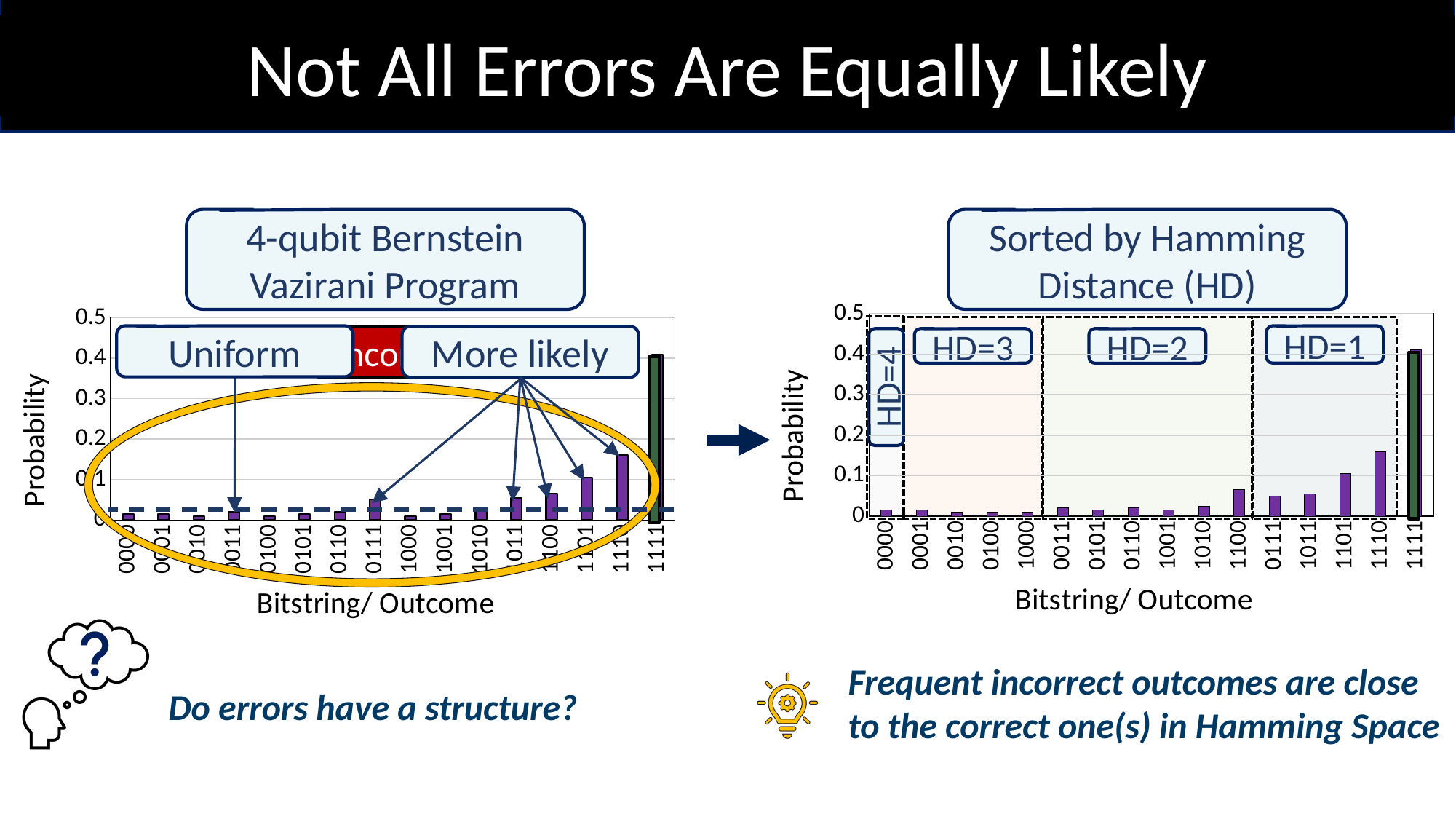
What kind of chart is the left chart titled '4-qubit Bernstein Vazirani Program'? bar chart What is the x-axis label of the right chart titled 'Sorted by Hamming Distance (HD)'? Bitstring/ Outcome In the right chart titled 'Sorted by Hamming Distance (HD)', which bitstring has the highest probability? 1111 In the left chart titled '4-qubit Bernstein Vazirani Program', is the probability for 1110 greater or less than 0.2? less In the left chart titled '4-qubit Bernstein Vazirani Program', how many bitstring categories are shown on the x axis? 16 What is the maximum value shown on the y axis of the left chart titled '4-qubit Bernstein Vazirani Program'? 0.5 In the left chart titled '4-qubit Bernstein Vazirani Program', which bitstring has the highest probability? 1111 In the right chart titled 'Sorted by Hamming Distance (HD)', which has the higher probability, 1110 or 0111? 1110 In the left chart titled '4-qubit Bernstein Vazirani Program', which has the higher probability, 1101 or 0011? 1101 In the left chart titled '4-qubit Bernstein Vazirani Program', is the probability for 1111 greater or less than 0.3? greater In the right chart titled 'Sorted by Hamming Distance (HD)', is the probability for 1101 greater or less than 0.2? less In the right chart titled 'Sorted by Hamming Distance (HD)', do the probabilities rise or fall across the bitstrings in the HD=1 group from 0111 to 1110? rise